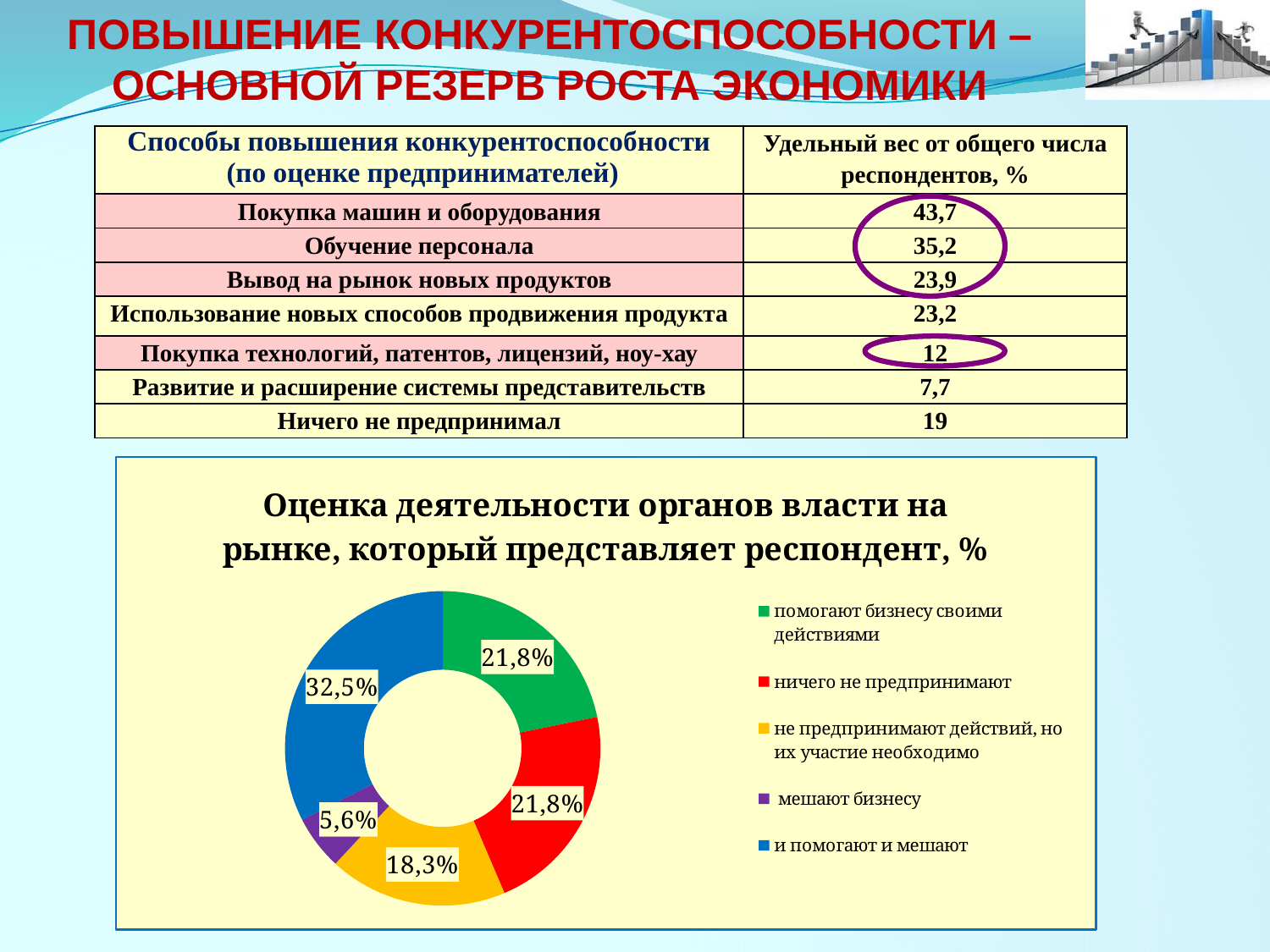
What share of respondents answered "и помогают и мешают"? 32,5% What colour represents "и помогают и мешают" in the chart? Blue What share of respondents answered "мешают бизнесу"? 5,6% Which category has the smallest share in the chart? мешают бизнесу What is the title of the chart on the slide? Оценка деятельности органов власти на рынке, который представляет респондент, % What is the difference between the share for "и помогают и мешают" and the share for "мешают бизнесу"? 26,9% Which category has the largest share in the chart? и помогают и мешают What kind of chart is shown on the slide? Doughnut (pie) chart Which is larger: the share for "ничего не предпринимают" or the share for "не предпринимают действий, но их участие необходимо"? ничего не предпринимают What share of respondents answered "помогают бизнесу своими действиями"? 21,8% What share of respondents answered "не предпринимают действий, но их участие необходимо"? 18,3% How many categories does the chart's legend list? 5